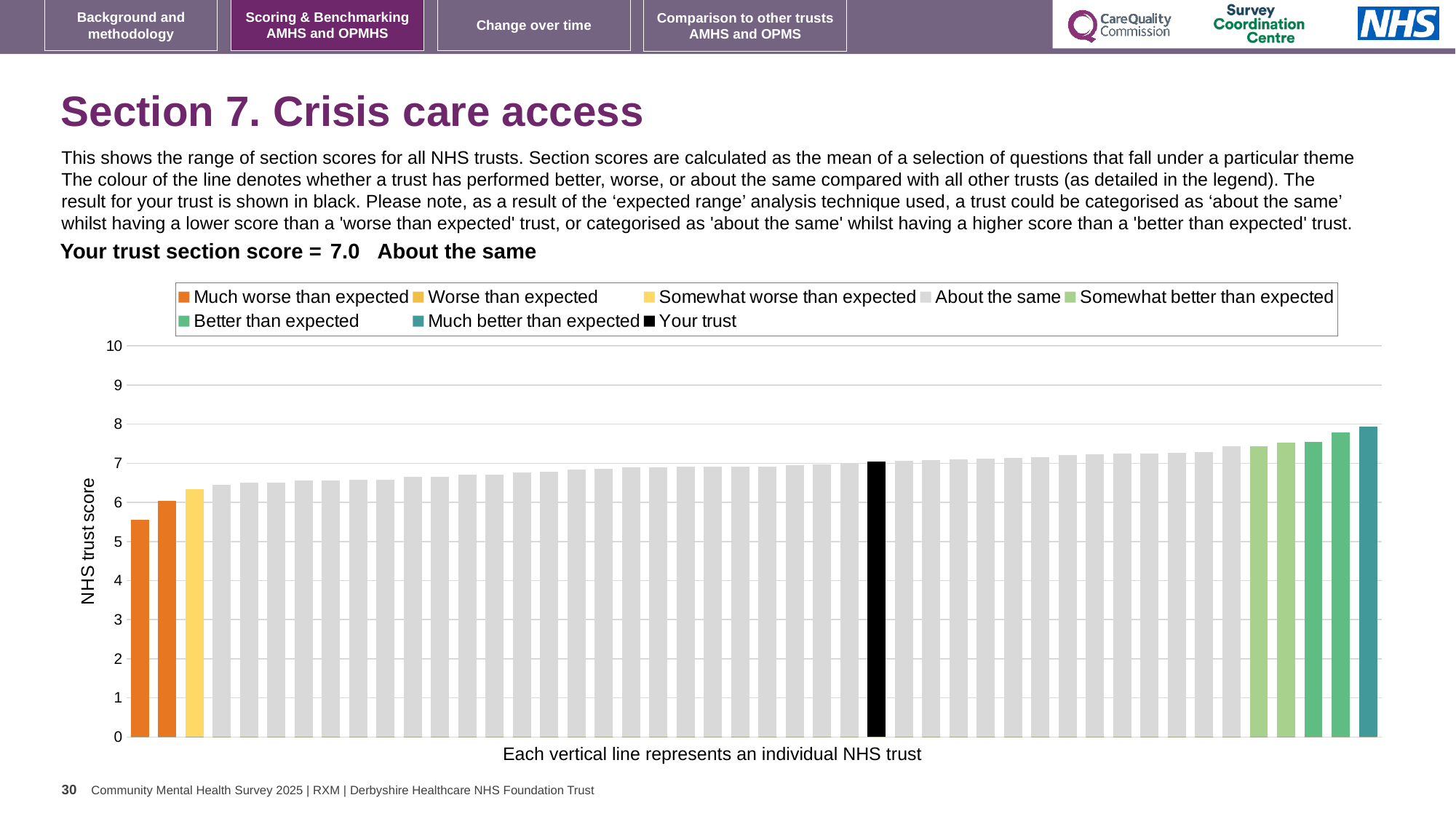
Is the value of the rightmost (tallest) bar greater or less than 7? greater Which legend category does the tallest bar belong to? Much better than expected How many bars are coloured orange ('Much worse than expected')? 2 What kind of chart is shown on the slide? bar chart Which legend category does the shortest bar belong to? Much worse than expected Is the value of the black 'Your trust' bar greater or less than 6? greater Do the bar values rise or fall from left to right along the x axis? rise Which category is your trust placed in for this section? About the same Is the value of the leftmost (shortest) bar greater or less than 6? less What is the section score for your trust shown on the slide? 7.0 How many entries does the chart legend list? 8 What is the label on the vertical axis of the chart? NHS trust score